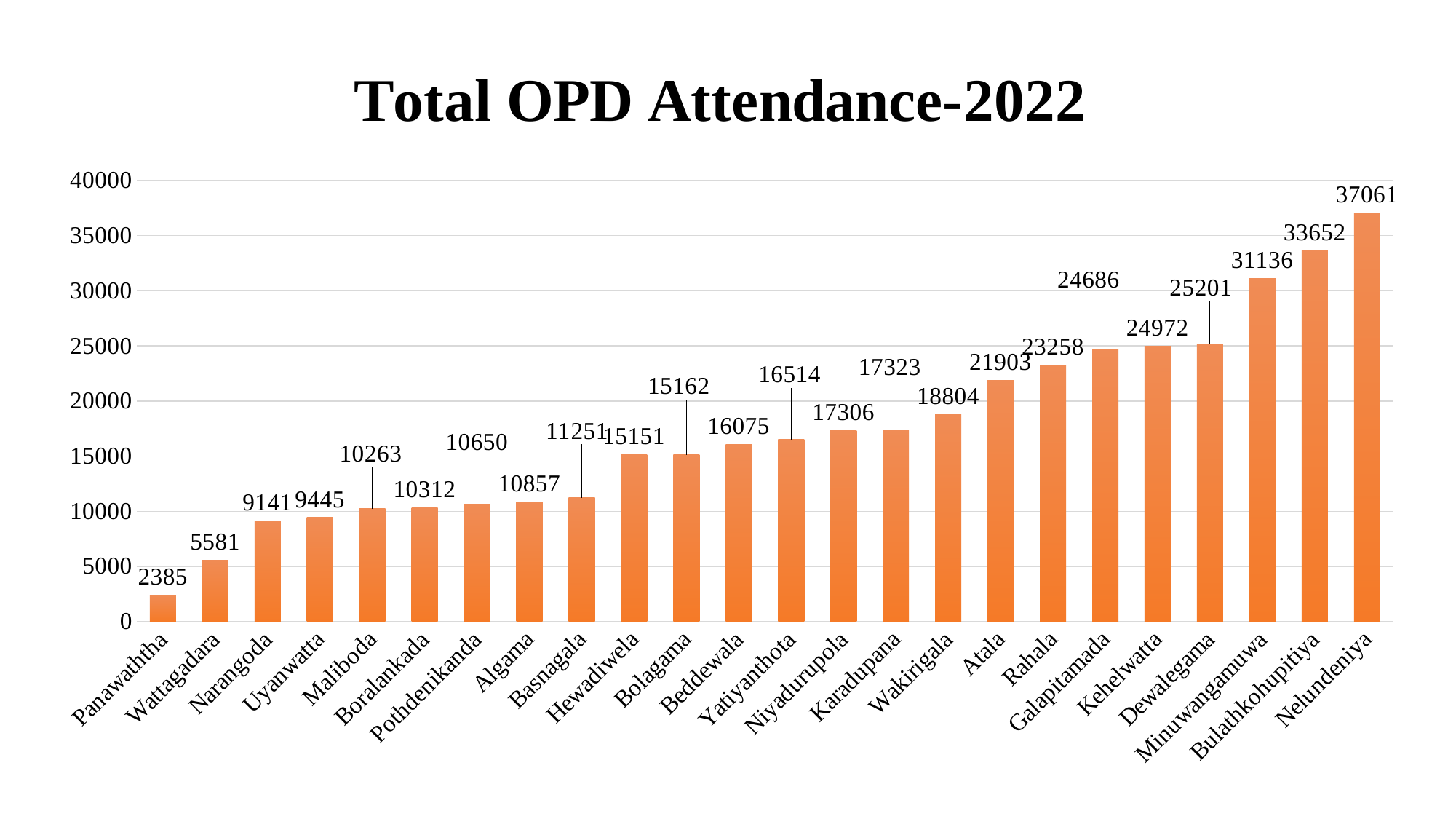
What is the total OPD attendance for Wakirigala? 18804 Which has a higher OPD attendance, Atala or Rahala? Rahala Is the value for Dewalegama greater or less than 25000? greater How many locations are shown on the chart? 24 Which location has the lowest total OPD attendance? Panawaththa Which location has the highest total OPD attendance? Nelundeniya What is the title of the chart? Total OPD Attendance-2022 What is the difference in OPD attendance between Wattagadara and Panawaththa? 3196 What is the total OPD attendance for Boralankada? 10312 What is the total OPD attendance for Nelundeniya? 37061 What is the difference in OPD attendance between Bulathkohupitiya and Minuwangamuwa? 2516 What kind of chart is shown on the slide? Bar chart